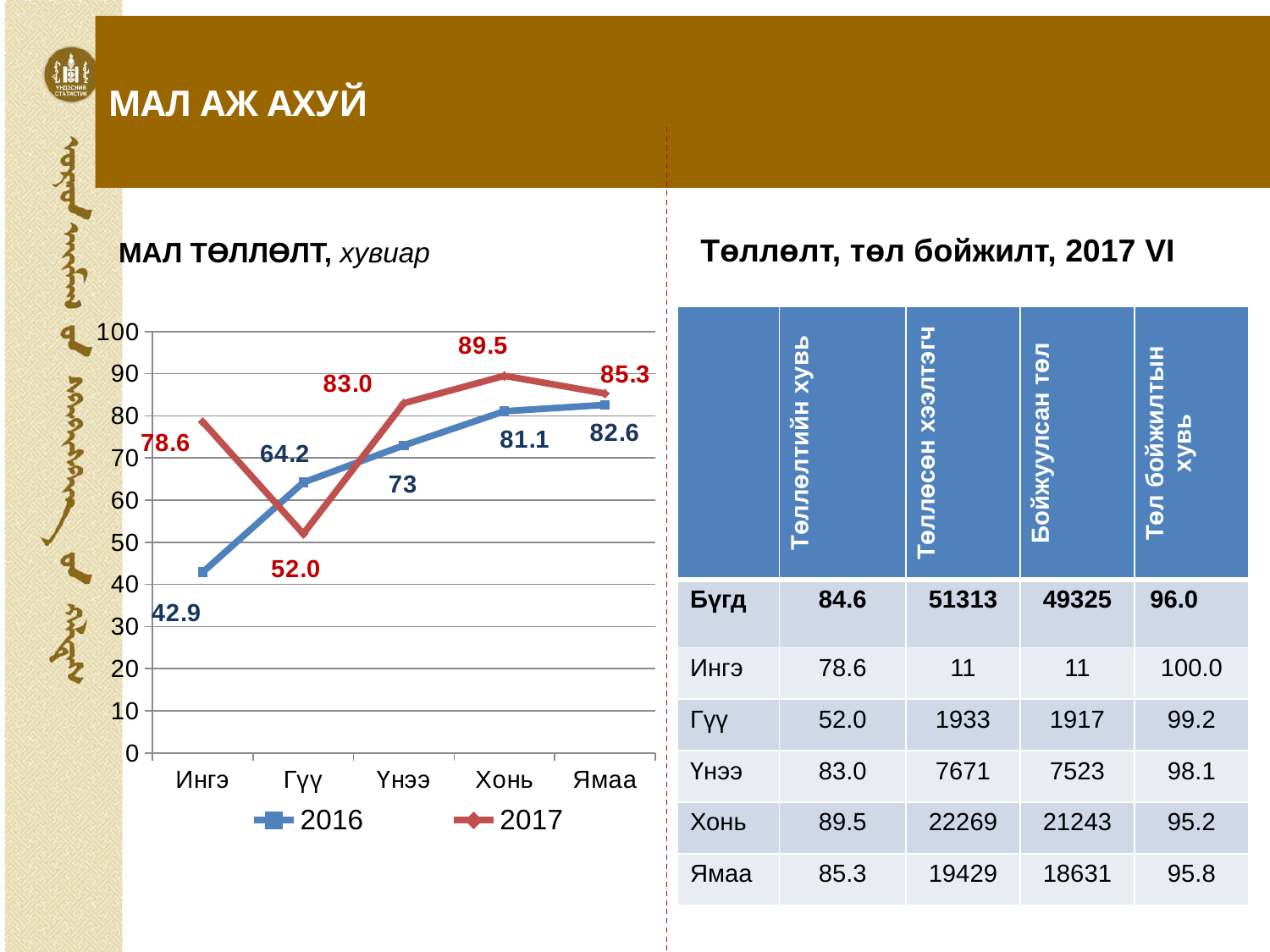
What is the 2017 value for Хонь in the chart? 89.5 Which colour is used for the 2017 series in the chart? red How many categories are plotted on the x axis of the chart? 5 Do the 2016 values rise or fall from Ингэ to Ямаа along the x axis? rise How many series does the chart legend list? 2 What type of chart is shown on the slide? line chart What is the 2017 value for Гүү in the chart? 52.0 Which category has the highest 2017 value in the chart? Хонь For Гүү, which series has the larger value, 2016 or 2017? 2016 Which category has the lowest 2016 value in the chart? Ингэ What is the difference between the 2017 and 2016 values for Ингэ? 35.7 What is the 2016 value for Ингэ in the chart? 42.9